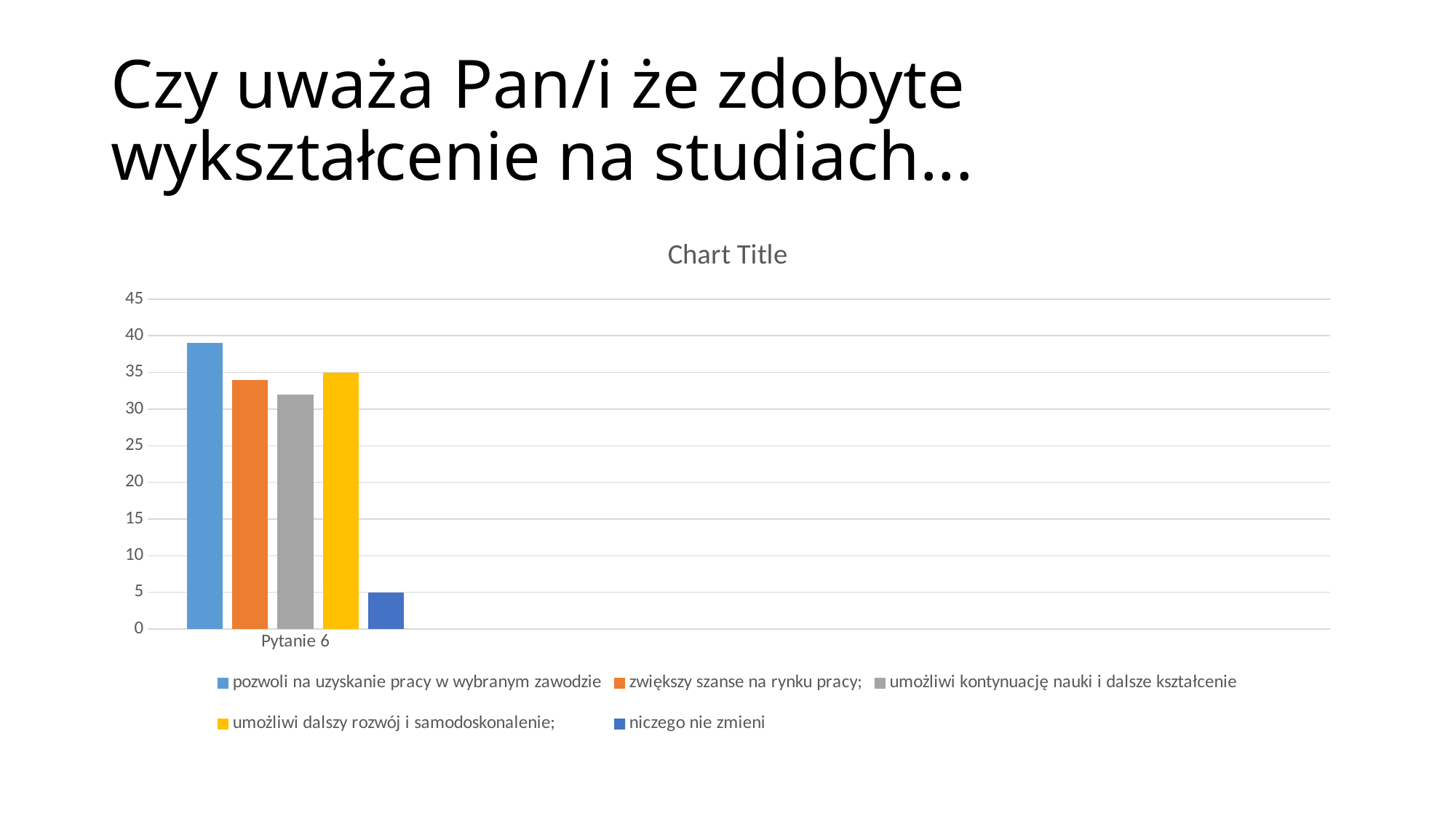
Is the value for 'pozwoli na uzyskanie pracy w wybranym zawodzie' greater or less than 35? greater Is the value for 'umożliwi kontynuację nauki i dalsze kształcenie' greater or less than 30? greater What is the value for 'umożliwi dalszy rozwój i samodoskonalenie;'? 35 Which series has the highest value for Pytanie 6? pozwoli na uzyskanie pracy w wybranym zawodzie How many categories are shown on the x axis? 1 How many series does the legend list? 5 Which is larger: the value for 'pozwoli na uzyskanie pracy w wybranym zawodzie' or the value for 'zwiększy szanse na rynku pracy;'? pozwoli na uzyskanie pracy w wybranym zawodzie Which series has the lowest value for Pytanie 6? niczego nie zmieni What is the value for 'niczego nie zmieni'? 5 What kind of chart is shown on the slide? bar chart What is the title shown above the chart? Chart Title What is the label of the category on the x axis? Pytanie 6